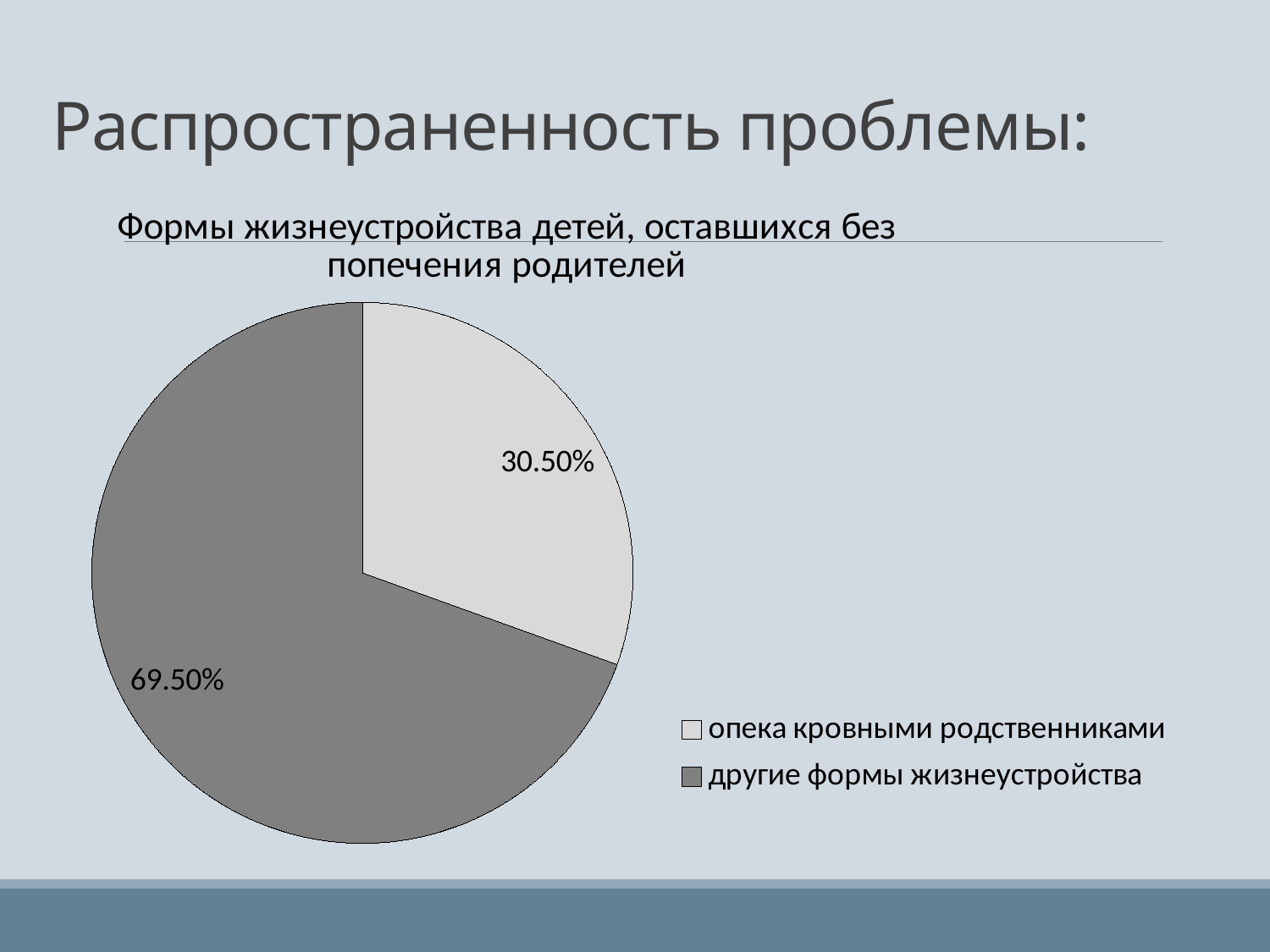
Which category has the largest slice of the pie? другие формы жизнеустройства Which category has the smallest slice of the pie? опека кровными родственниками What kind of chart is shown on the slide? pie chart What share of the pie is labelled for 'другие формы жизнеустройства'? 69.50% What share of the pie is labelled for 'опека кровными родственниками'? 30.50% Which is larger: the slice for 'опека кровными родственниками' or the slice for 'другие формы жизнеустройства'? другие формы жизнеустройства What is the chart's title? Формы жизнеустройства детей, оставшихся без попечения родителей Which legend entry is shown in the darker grey colour? другие формы жизнеустройства What is the difference in percentage points between 'другие формы жизнеустройства' and 'опека кровными родственниками'? 39 percentage points How many slices does the pie chart have? 2 How many entries does the legend list? 2 What is the total of the two slice percentages shown? 100%